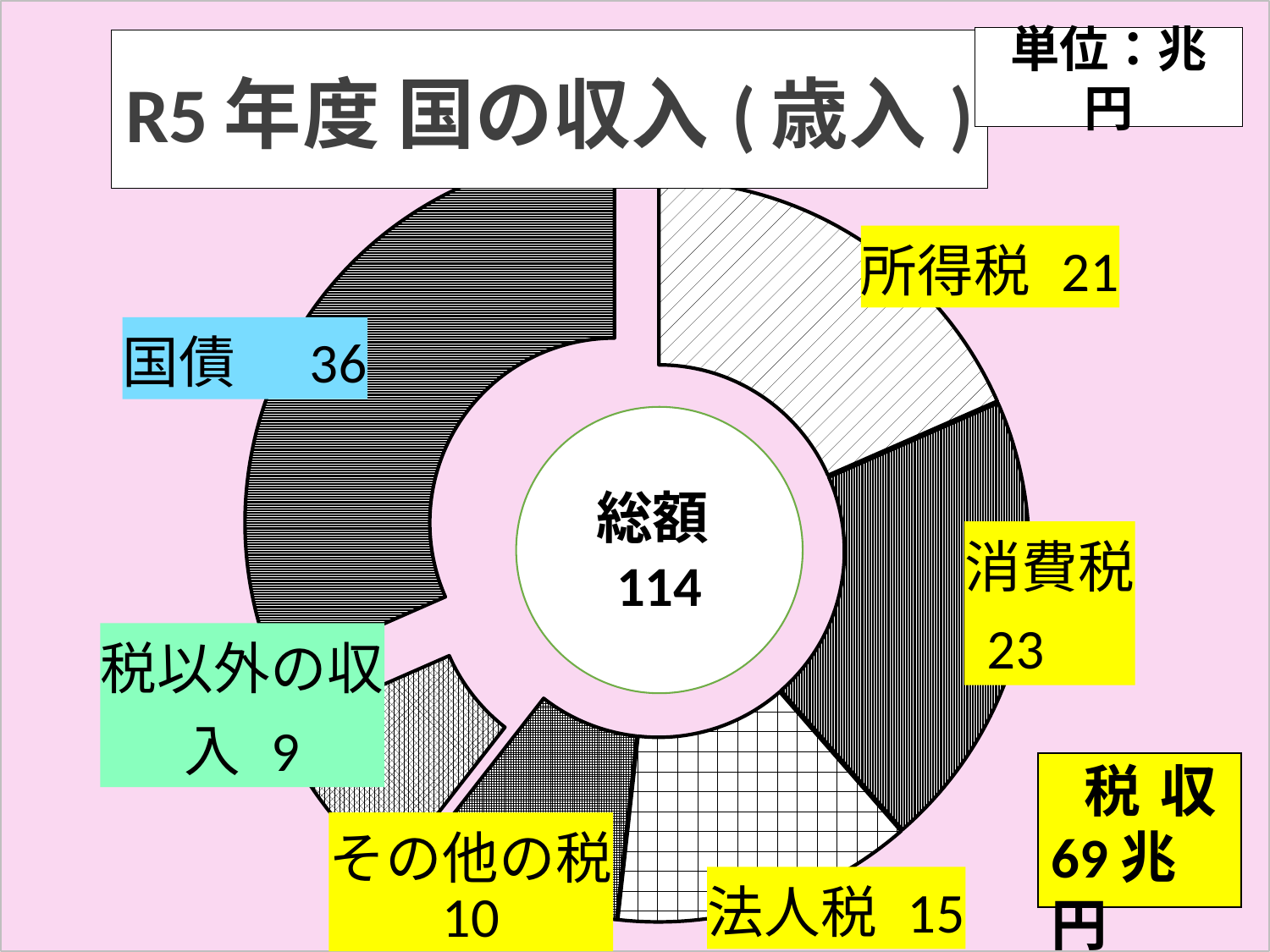
Which category has the largest value? 国債 Which is larger, 法人税 or その他の税? 法人税 What total (総額) is shown in the centre of the chart? 114 What is the value for 所得税 (income tax)? 21 What is the value for 税以外の収入 (non-tax revenue)? 9 What is the value for 消費税 (consumption tax)? 23 Which category has the smallest value? 税以外の収入 How many categories are shown in the chart? 6 What is the difference between 消費税 and 所得税? 2 What is the value for 国債 (government bonds)? 36 What type of chart is shown on the slide? Doughnut (pie) chart What is the value for 法人税 (corporate tax)? 15